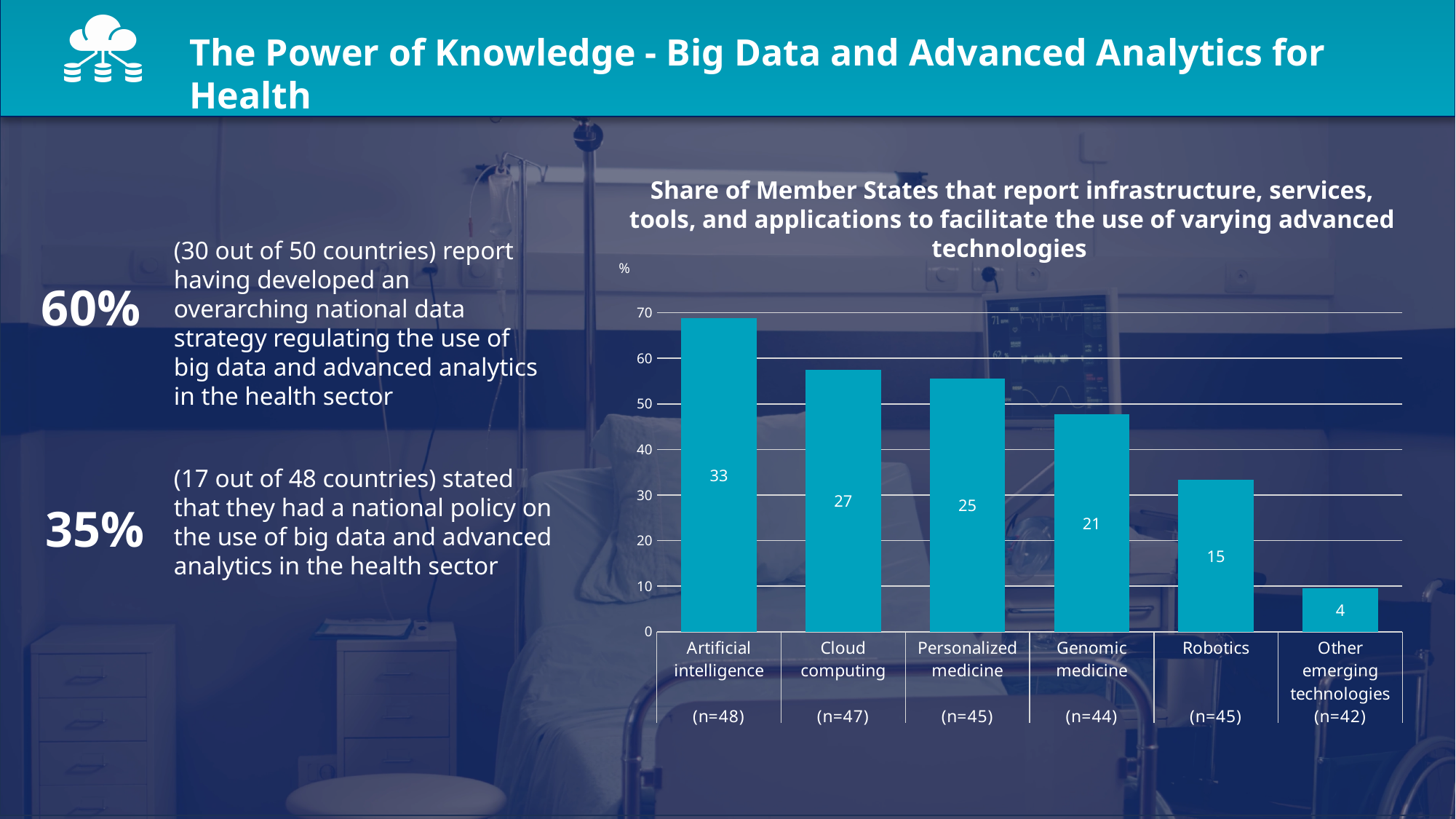
What kind of chart is shown on the slide? Bar chart Which bar is taller, Genomic medicine or Robotics? Genomic medicine Is the value for Artificial intelligence greater or less than 60%? greater What sample size (n) is shown for Cloud computing? n=47 Is the value for Robotics greater or less than 40%? less What data label is printed on the bar for Robotics? 15 What data label is printed on the bar for Artificial intelligence? 33 Which technology has the highest bar in the chart? Artificial intelligence What data label is printed on the bar for Other emerging technologies? 4 What is the difference between the data labels for Artificial intelligence and Cloud computing? 6 Which technology has the lowest bar in the chart? Other emerging technologies How many technology categories are shown on the x axis? 6